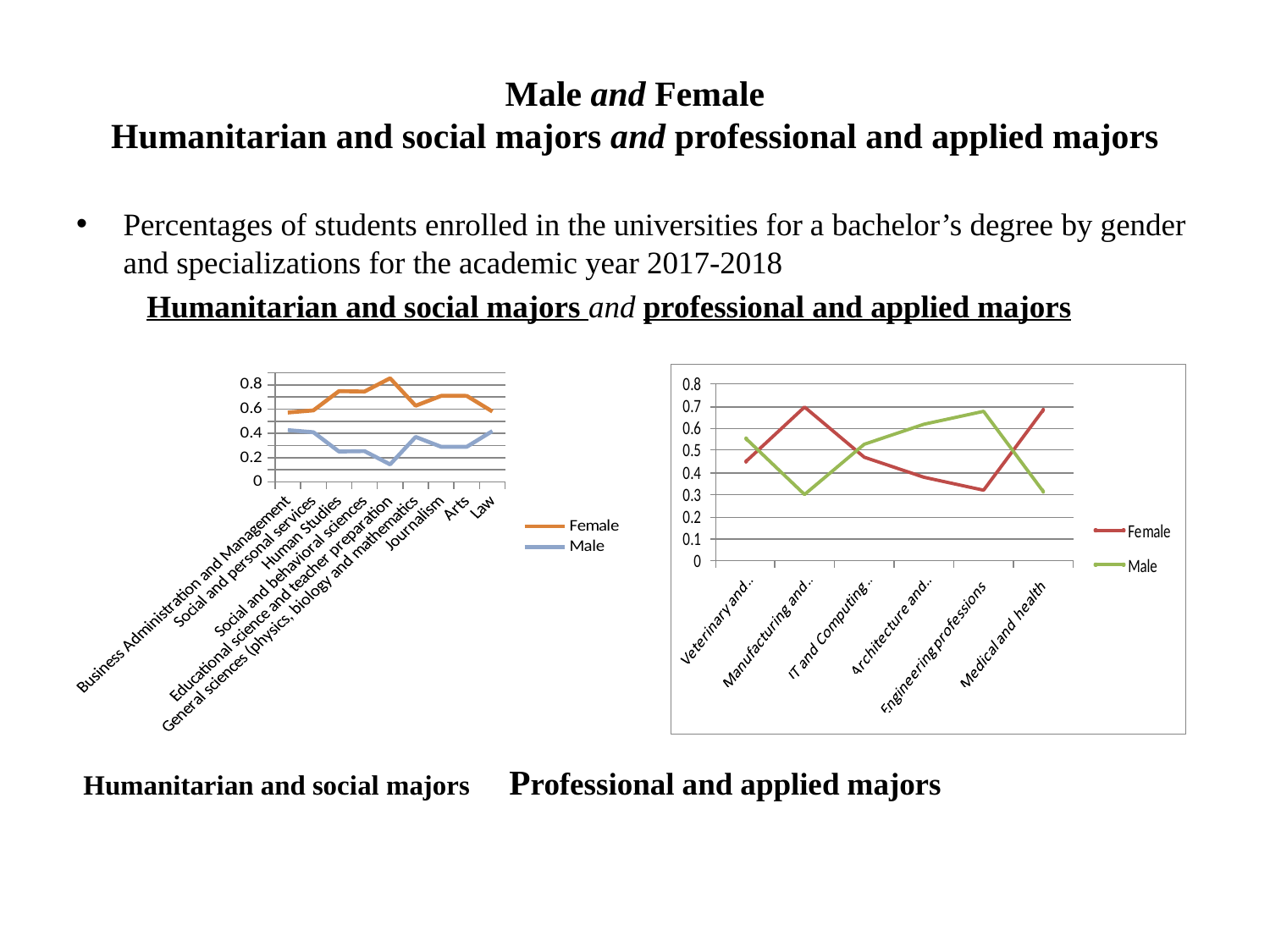
In the right chart (Professional and applied majors), which category has the highest Male value? Engineering professions In the left chart (Humanitarian and social majors), is the Female value for Human Studies greater or less than 0.6? greater How many categories are shown on the x axis of the left chart (Humanitarian and social majors)? 9 In the left chart (Humanitarian and social majors), is the Male value for Human Studies greater or less than 0.4? less How many series does the legend of the right chart (Professional and applied majors) list? 2 In the right chart (Professional and applied majors), is the Female value for Manufacturing greater or less than 0.6? greater What are the two series named in the legend of the left chart (Humanitarian and social majors)? Female and Male In the right chart (Professional and applied majors), which series is larger for Engineering professions, Female or Male? Male What kind of chart is the left chart (Humanitarian and social majors)? line chart How many categories are shown on the x axis of the right chart (Professional and applied majors)? 6 In the left chart (Humanitarian and social majors), which category has the highest Female value? Educational science and teacher preparation In the left chart (Humanitarian and social majors), which category has the lowest Male value? Educational science and teacher preparation